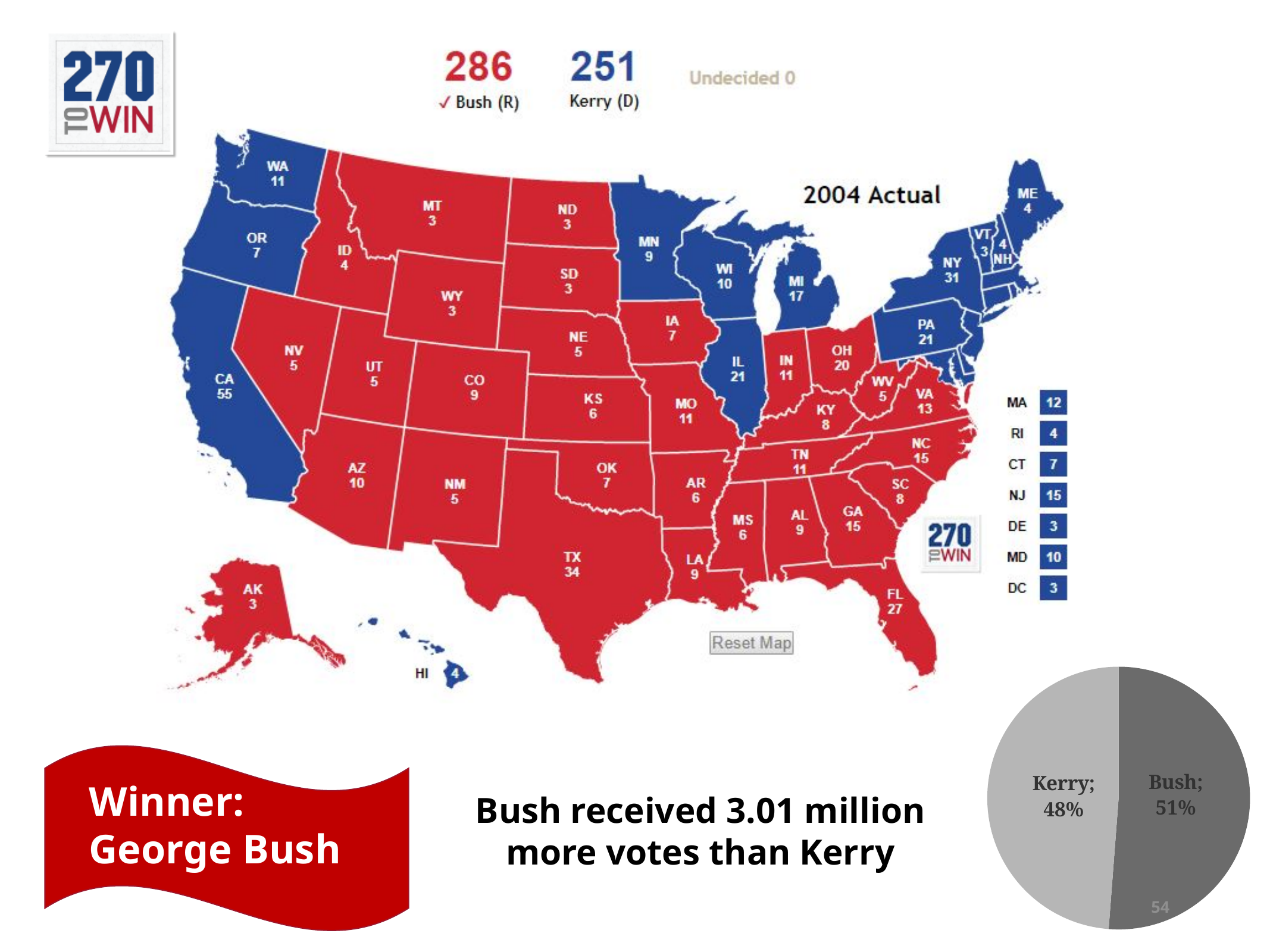
On the 2004 electoral map, what is the difference between Bush's and Kerry's electoral vote totals? 35 In the pie chart at the bottom right, which candidate has the larger slice? Bush On the 2004 electoral map, how many electoral votes are shown for TX? 34 In the pie chart at the bottom right, which candidate's slice is the darker grey? Bush In the pie chart at the bottom right, by how many percentage points does Bush's share exceed Kerry's? 3 percentage points On the 2004 electoral map, how many electoral votes are shown for Bush (R)? 286 In the pie chart at the bottom right, what share of the vote is shown for Kerry? 48% On the 2004 electoral map, how many electoral votes are shown for CA? 55 How many slices does the pie chart at the bottom right have? 2 On the 2004 electoral map, how many electoral votes are shown for Kerry (D)? 251 What kind of chart is shown at the bottom right of the slide? Pie chart In the pie chart at the bottom right, what share of the vote is shown for Bush? 51%